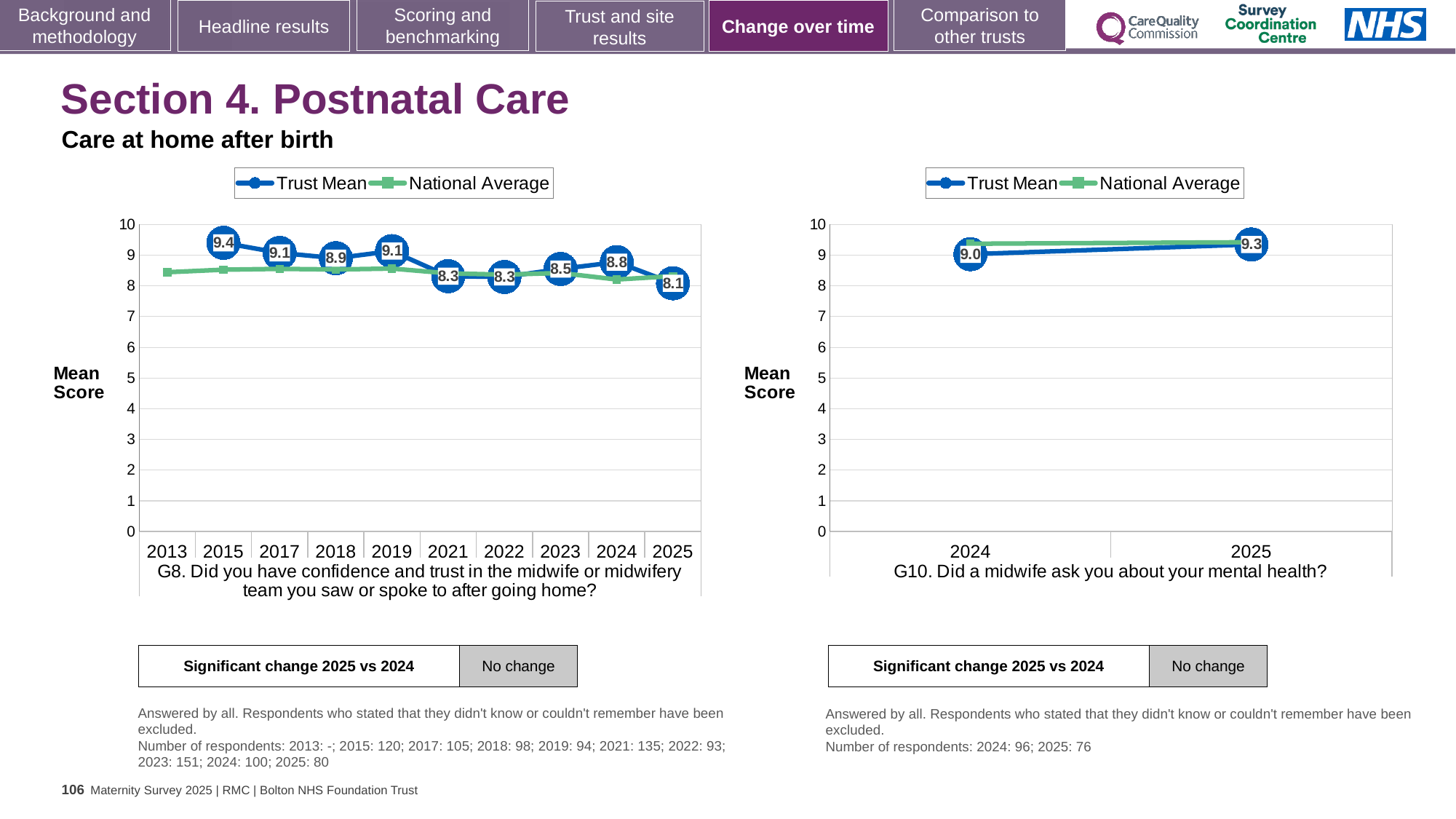
In the G8 chart on the left, what is the difference between the Trust Mean scores for 2024 and 2025? 0.7 In the G8 chart on the left, which year has the lowest Trust Mean score? 2025 In the G8 chart on the left, which year has the larger Trust Mean score, 2019 or 2021? 2019 In the G8 chart on the left, what is the Trust Mean score for 2015? 9.4 In the G8 chart on the left, which year has the highest Trust Mean score? 2015 How many years are shown on the x axis of the G8 chart on the left? 10 How many series does the legend of the G10 chart on the right list? 2 In the G10 chart on the right, what is the Trust Mean score for 2024? 9.0 In the G8 chart on the left, what is the Trust Mean score for 2025? 8.1 In the G8 chart on the left, is the National Average value for 2013 greater or less than 9? less In the G10 chart on the right, what is the difference between the Trust Mean scores for 2025 and 2024? 0.3 What kind of chart is the G10 chart on the right? Line chart